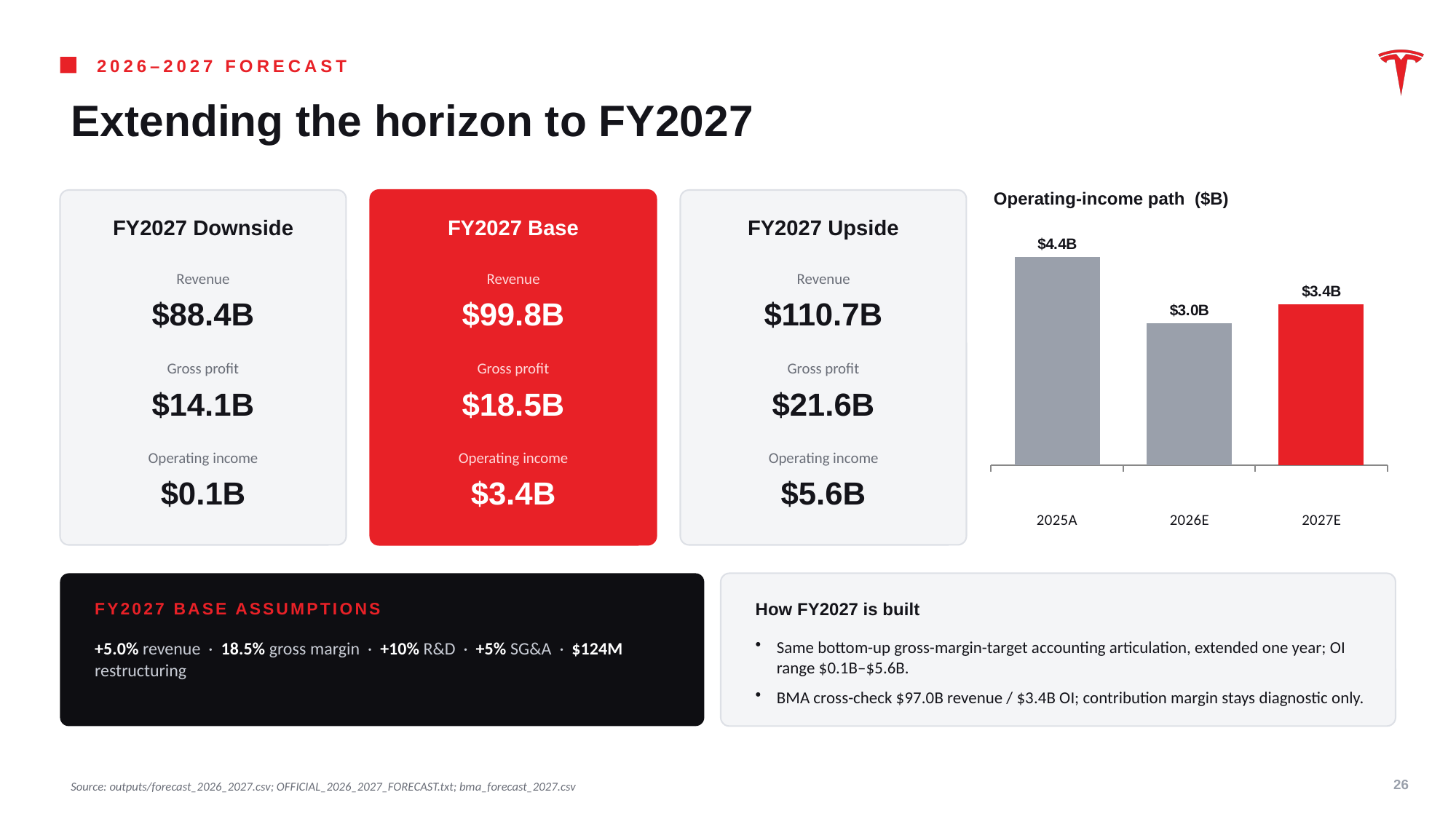
Which year has the lowest operating income in the Operating-income path chart? 2026E Which bar in the Operating-income path chart is coloured red? 2027E What is the difference between the 2025A and 2026E operating income values in the chart? $1.4B Is the operating income for 2027E larger or smaller than for 2025A in the chart? smaller What is the difference between the 2027E and 2026E operating income values in the chart? $0.4B What is the title of the chart on the right side of the slide? Operating-income path ($B) How many years are plotted in the Operating-income path chart? 3 What is the operating income shown for 2025A in the Operating-income path chart? $4.4B What type of chart is the Operating-income path chart? bar chart What is the operating income shown for 2026E in the Operating-income path chart? $3.0B Which year has the highest operating income in the Operating-income path chart? 2025A What is the operating income shown for 2027E in the Operating-income path chart? $3.4B